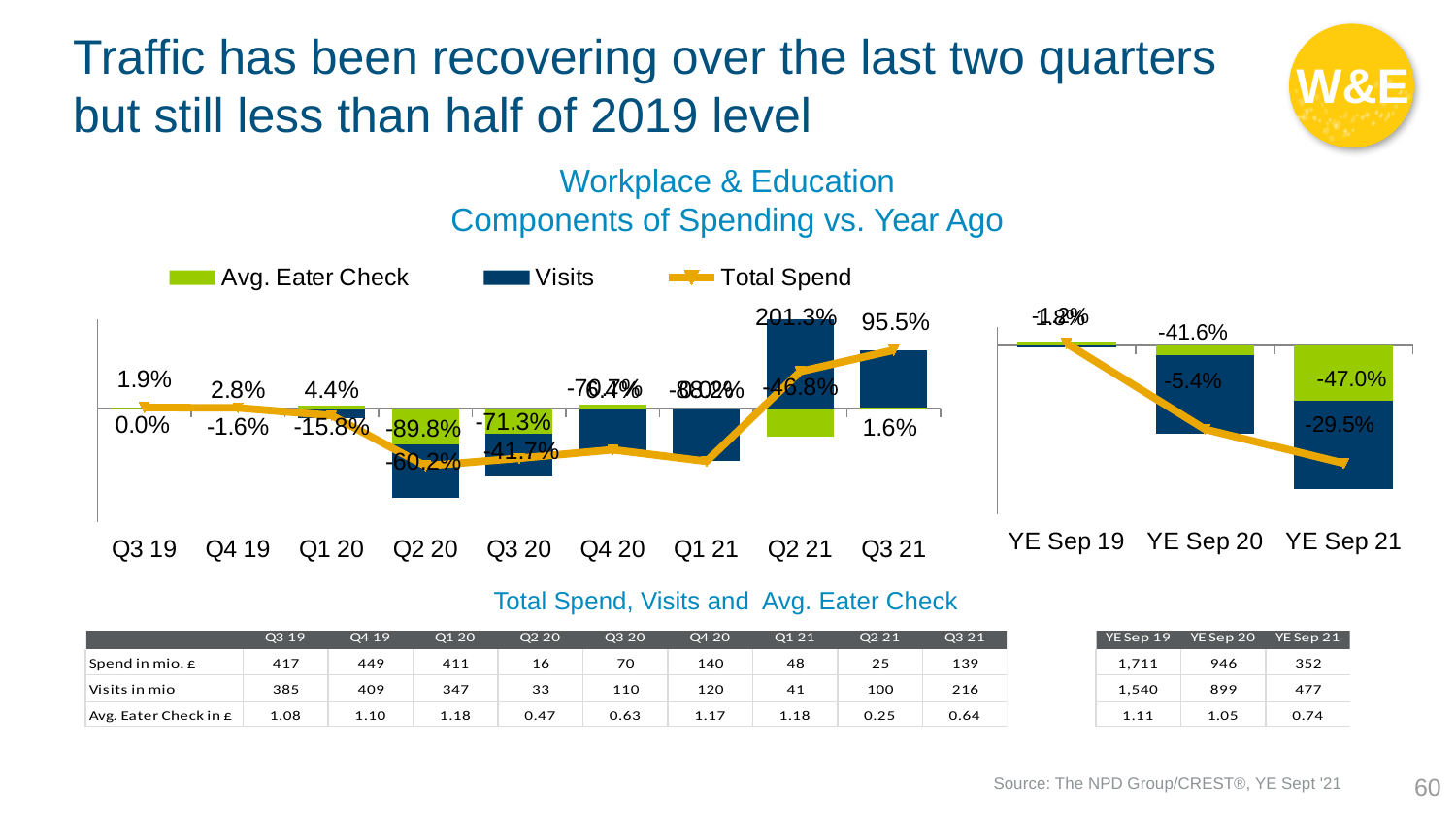
In the table below the left chart, what is Spend in mio. £ for Q3 21? 139 In the left chart, what is the Visits value for Q2 21? 201.3% In the table below the right chart, what is Visits in mio for YE Sep 21? 477 How many quarters are shown on the x axis of the left chart? 9 In the left chart, which quarter has the highest Visits value? Q2 21 How many series does the legend list? 3 In the left chart, what is the Visits value for Q3 21? 95.5% What kind of chart is the left chart (Q3 19 to Q3 21)? Combined stacked bar and line chart In the left chart, what is the Avg. Eater Check value for Q3 21? 1.6% How many periods are shown on the x axis of the right chart? 3 In the left chart, what is the Visits value for Q3 20? -71.3% In the right chart, what is the Visits value for YE Sep 20? -41.6%